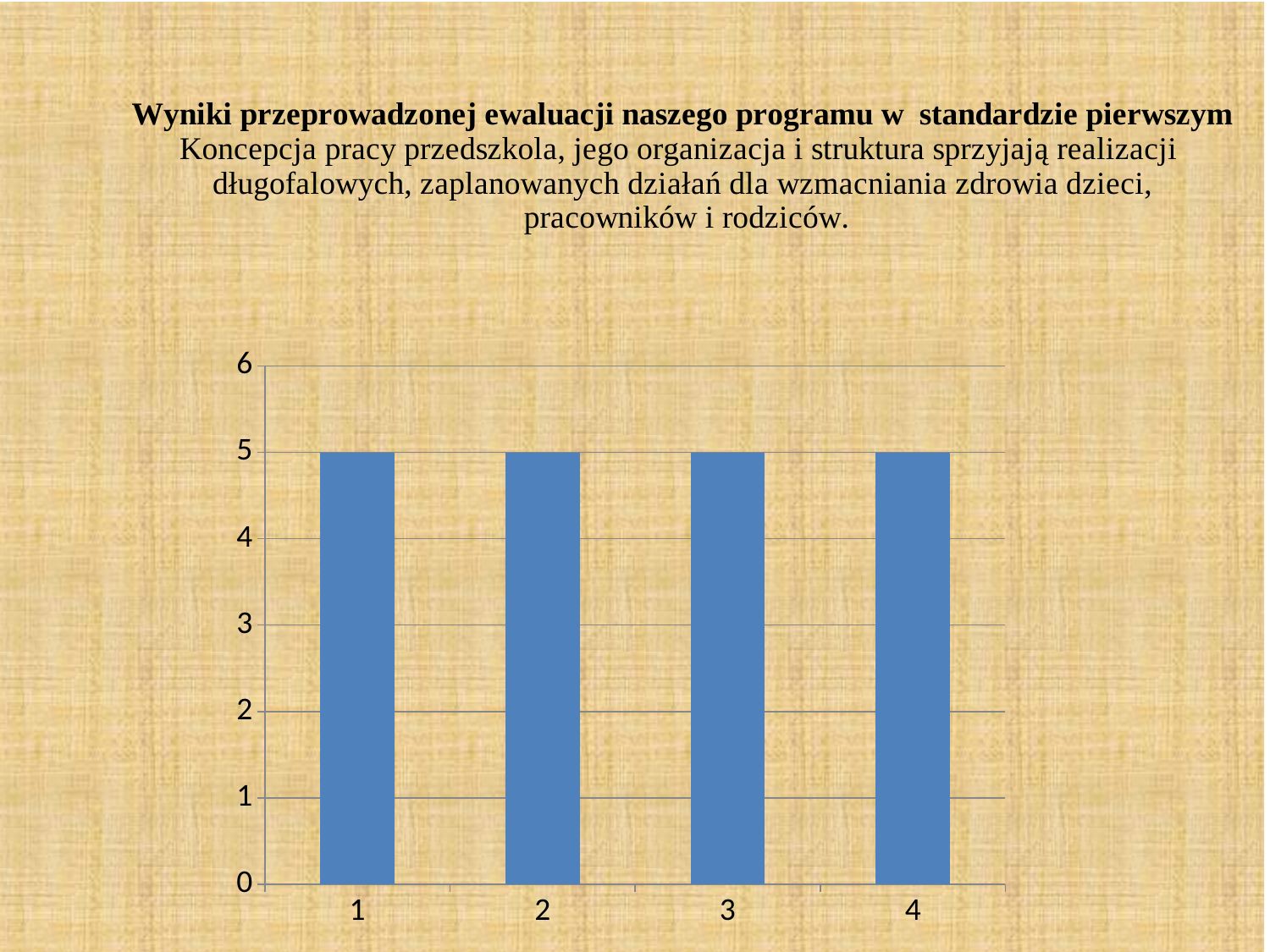
Do the values rise, fall, or stay the same from category 1 to category 4? stay the same What is the difference between the values for category 1 and category 4? 0 What is the value of the bar for category 3? 5 What is the value of the bar for category 1? 5 What is the value of the bar for category 2? 5 Is the value for category 3 greater or less than 4? greater What kind of chart is shown on the slide? bar chart What is the highest value shown on the vertical axis of the chart? 6 What is the value of the bar for category 4? 5 How many categories are shown on the x axis of the chart? 4 Is the value for category 1 greater or less than 6? less What colour are the bars in the chart? blue